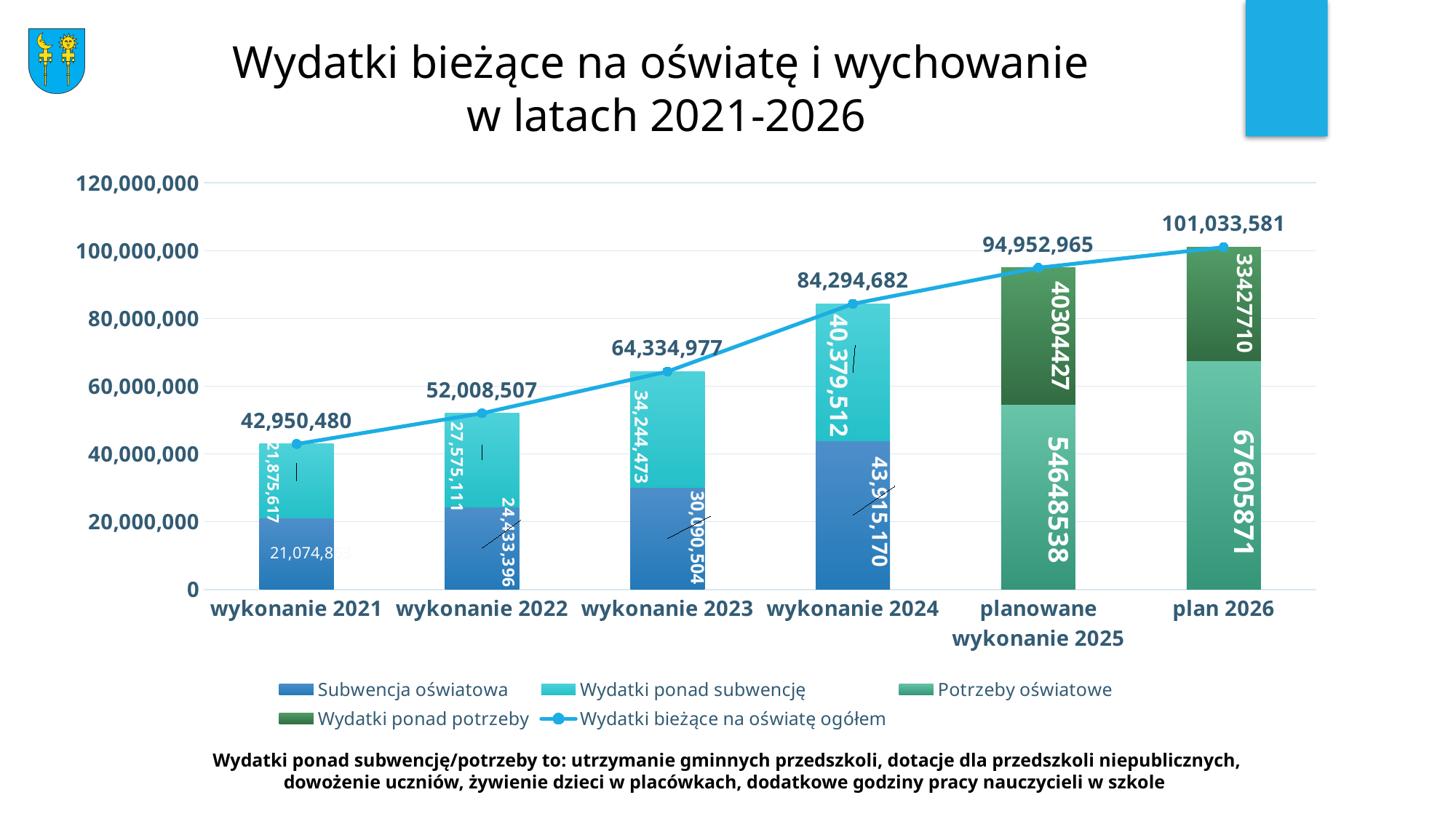
What is the value of Wydatki bieżące na oświatę ogółem for plan 2026? 101,033,581 Which category has the highest value of Wydatki bieżące na oświatę ogółem? plan 2026 What is the difference between Wydatki bieżące na oświatę ogółem for plan 2026 and planowane wykonanie 2025? 6,080,616 Which is larger: Subwencja oświatowa for wykonanie 2024 or Wydatki ponad subwencję for wykonanie 2024? Subwencja oświatowa Which category has the lowest value of Wydatki bieżące na oświatę ogółem? wykonanie 2021 What is the value of Wydatki ponad subwencję for wykonanie 2023? 34,244,473 What is the value of Wydatki bieżące na oświatę ogółem for wykonanie 2021? 42,950,480 What is the value of Potrzeby oświatowe for planowane wykonanie 2025? 54648538 What is the value of Subwencja oświatowa for wykonanie 2024? 43,915,170 How many series does the legend list? 5 How many categories are shown on the x axis? 6 What is the value of Wydatki ponad potrzeby for plan 2026? 33427710